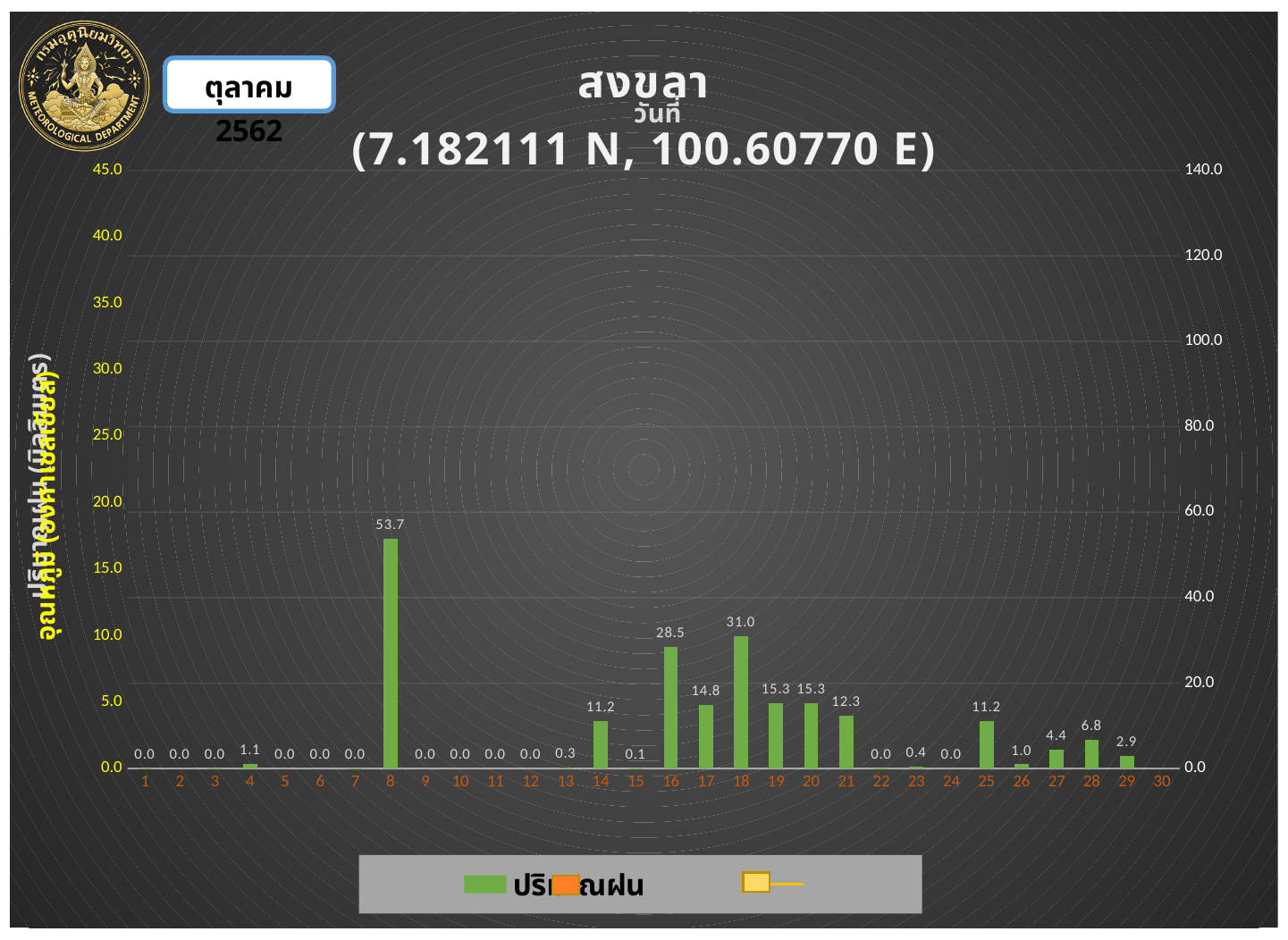
What is the total rainfall for days 19 and 20 combined? 30.6 What is the rainfall value shown for day 16? 28.5 What is the rainfall value shown for day 18? 31.0 What kind of chart is shown on the slide? bar chart What is the difference between the rainfall values for day 8 and day 18? 22.7 What are the coordinates shown in the chart title? 7.182111 N, 100.60770 E What is the difference between the rainfall values for day 16 and day 17? 13.7 Which day has the highest rainfall value? 8 Which is larger, the rainfall value for day 28 or for day 29? day 28 What is the rainfall value shown for day 27? 4.4 What is the rainfall value shown for day 8? 53.7 Which is larger, the rainfall value for day 21 or for day 25? day 21